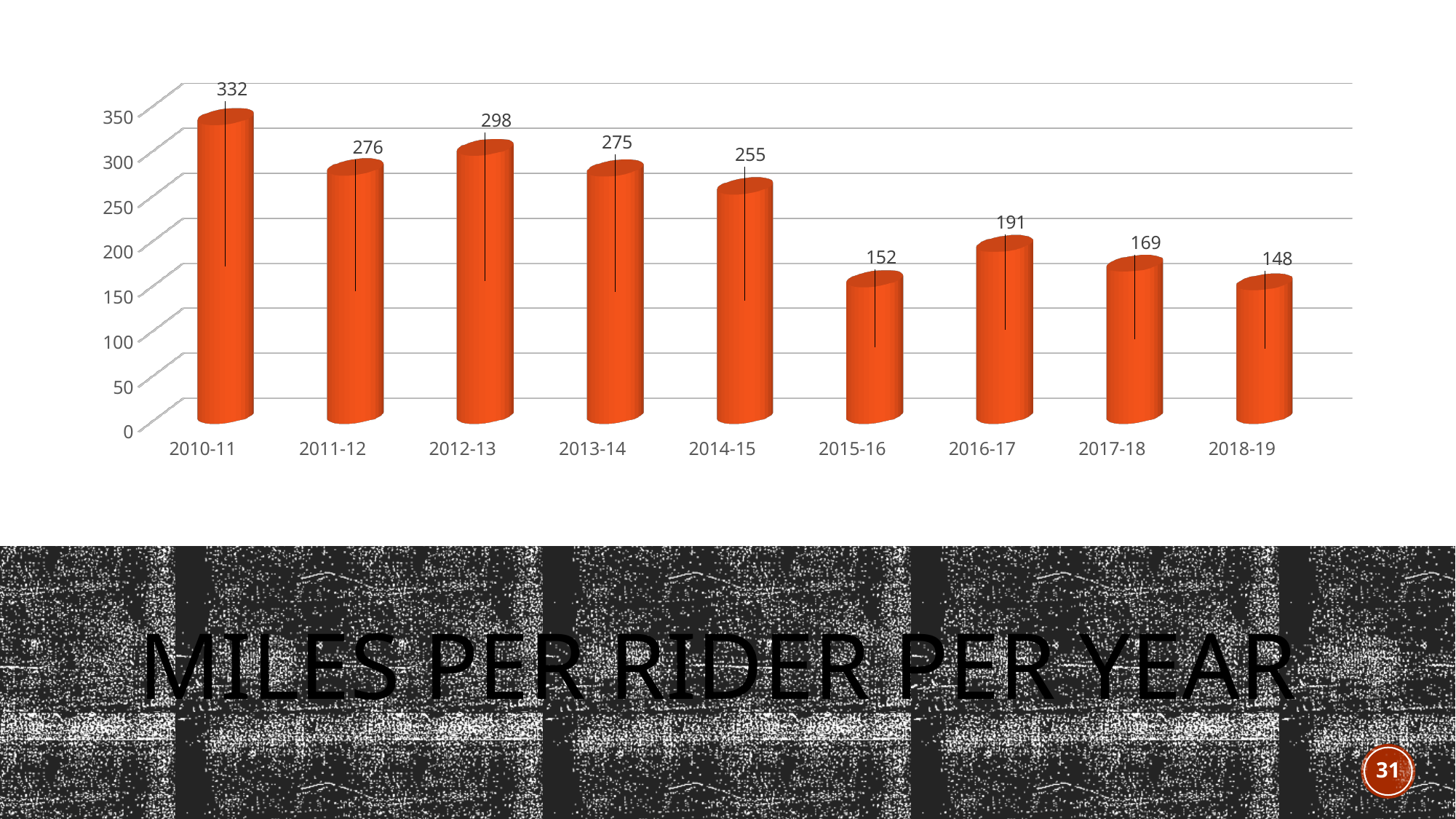
What is the difference between the values for 2014-15 and 2015-16? 103 What is the title of the slide? MILES PER RIDER PER YEAR Which year has the lowest value? 2018-19 What is the value for 2015-16? 152 How many years are shown on the chart? 9 What kind of chart is shown on the slide? bar chart What is the value for 2010-11? 332 Which is larger, the value for 2016-17 or the value for 2017-18? 2016-17 Is the value for 2012-13 greater or less than 250? greater Which year has the highest value? 2010-11 What is the value for 2018-19? 148 What is the difference between the values for 2010-11 and 2018-19? 184